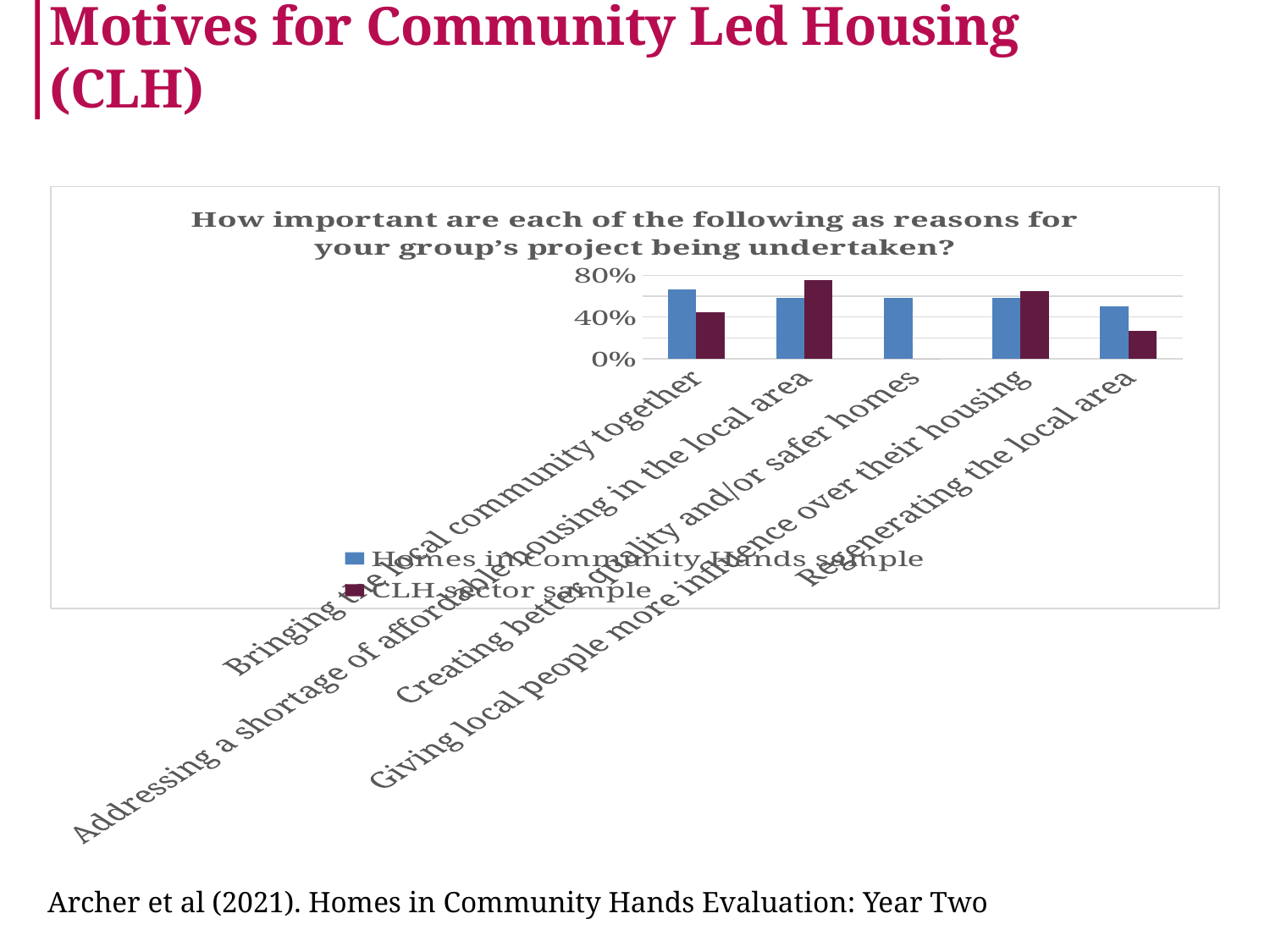
Is the Homes in Community Hands sample value for 'Bringing the local community together' greater or less than 40%? greater Which series has the higher value for 'Regenerating the local area'? Homes in Community Hands sample Which colour represents the CLH sector sample series in the chart? Dark red Which series has the highest value for 'Addressing a shortage of affordable housing in the local area'? CLH sector sample Which category has no CLH sector sample bar shown? Creating better quality and/or safer homes Is the CLH sector sample value for 'Regenerating the local area' greater or less than 40%? less For which category is the CLH sector sample value highest? Addressing a shortage of affordable housing in the local area Which series has the higher value for 'Bringing the local community together'? Homes in Community Hands sample What kind of chart is shown on the slide? Bar chart How many series does the chart's legend list? 2 How many reason categories are shown along the x axis of the chart? 5 For which category is the Homes in Community Hands sample value lowest? Regenerating the local area